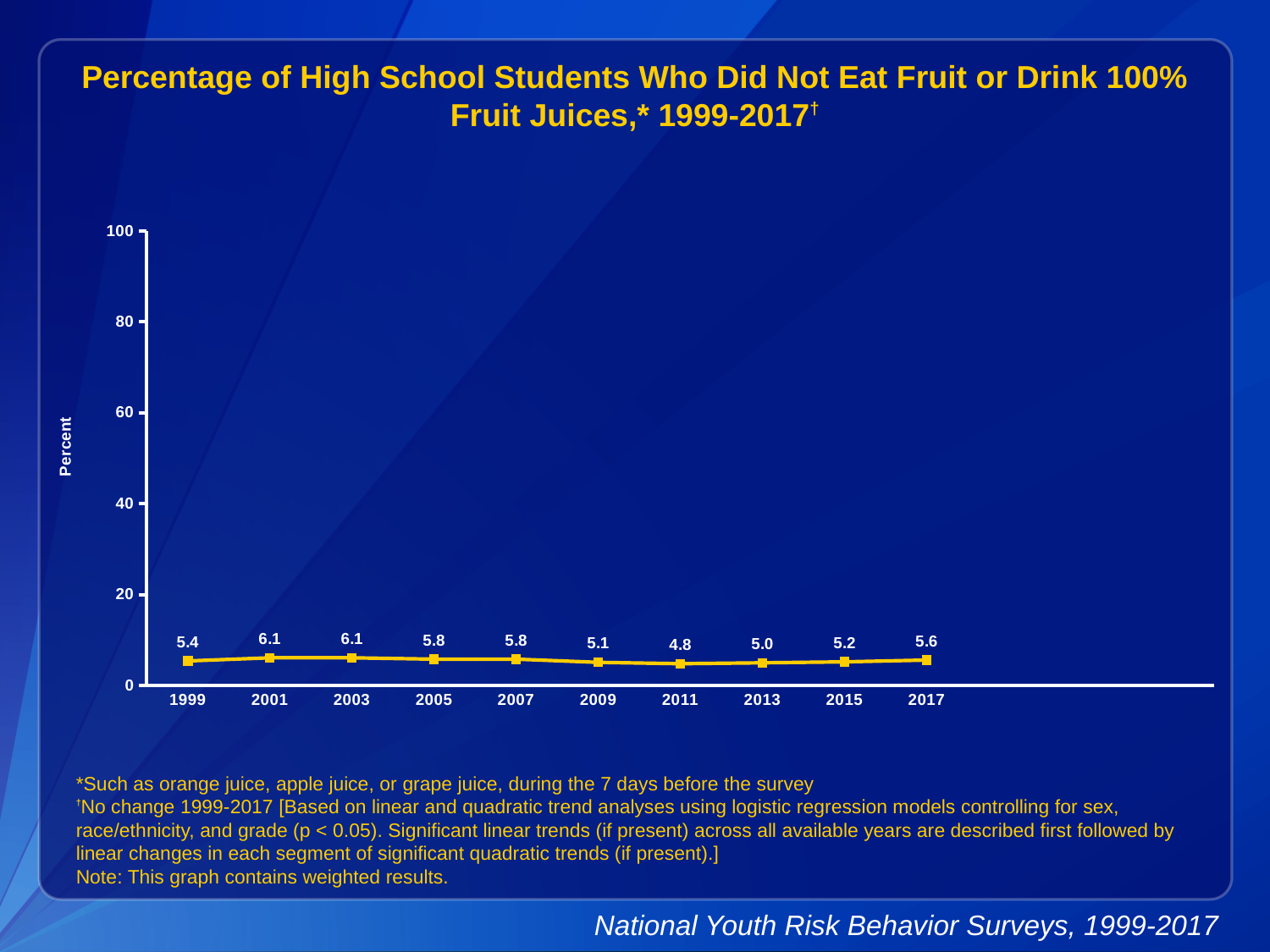
What is the label of the y axis? Percent What is the difference between the values for 2003 and 2011? 1.3 Which is larger, the value for 1999 or the value for 2001? 2001 Which year has the lowest value? 2011 What kind of chart is shown? line chart What is the value for 2017? 5.6 Do the values rise or fall from 2003 to 2011? fall How many years are plotted on the chart? 10 Is the value for 2007 greater or less than 20? less What is the value for 2011? 4.8 What is the highest tick value shown on the y axis? 100 What is the value for 1999? 5.4